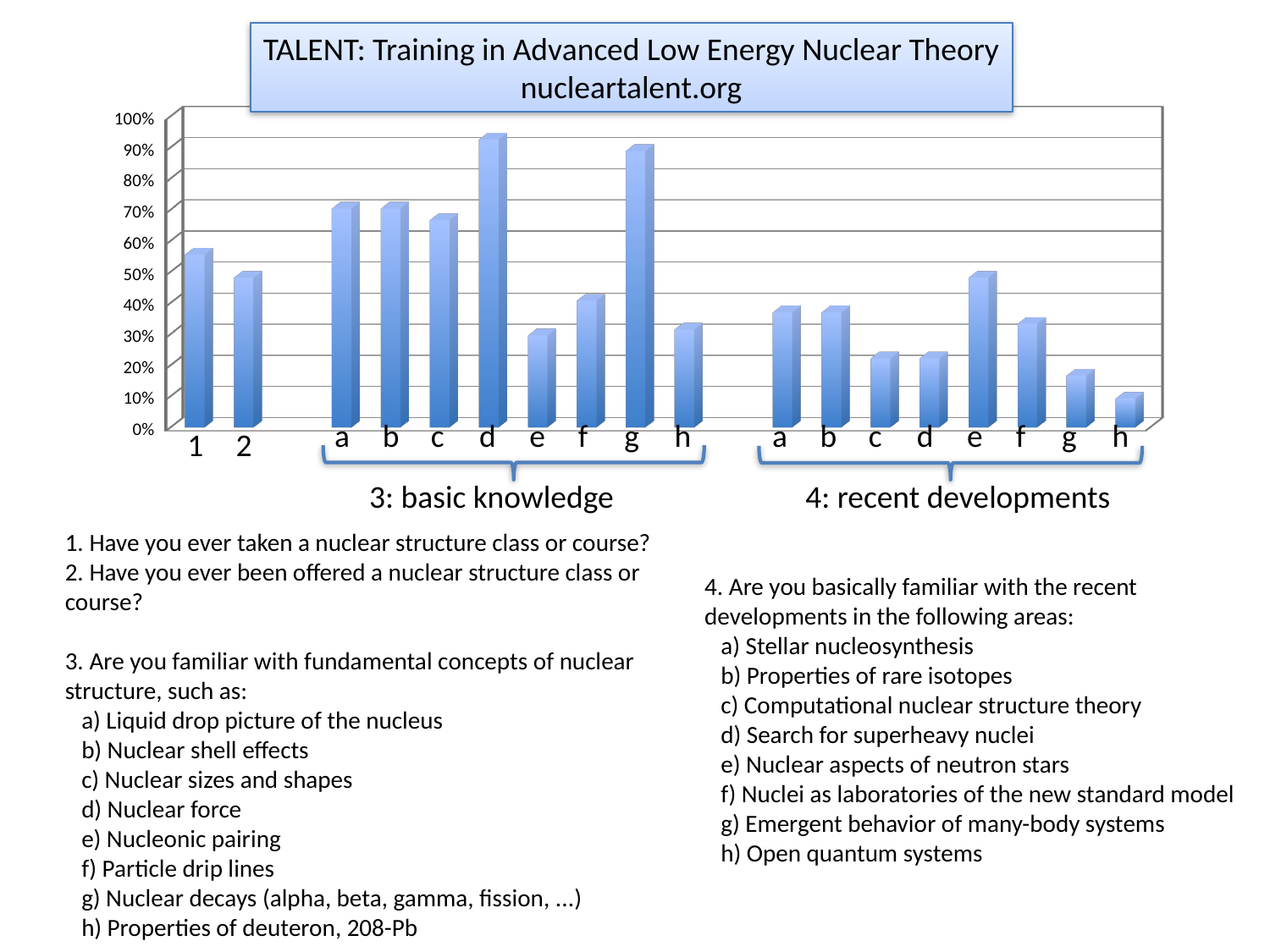
Which bar is the lowest in the chart? 4h (Open quantum systems) Is the value for question 3d greater or less than 80%? greater How many bars are plotted in the chart? 18 Is the value for question 3e greater or less than 40%? less Which is larger, the bar for 3a or the bar for 3e? 3a Is the value for question 4h greater or less than 20%? less Within the '4: recent developments' group, which item has the highest bar? e (Nuclear aspects of neutron stars) What kind of chart is shown on the slide? bar chart What is the title shown in the box above the chart? TALENT: Training in Advanced Low Energy Nuclear Theory nucleartalent.org Which bar is the highest in the chart? 3d (Nuclear force) Which is larger, the bar for question 1 or the bar for question 2? question 1